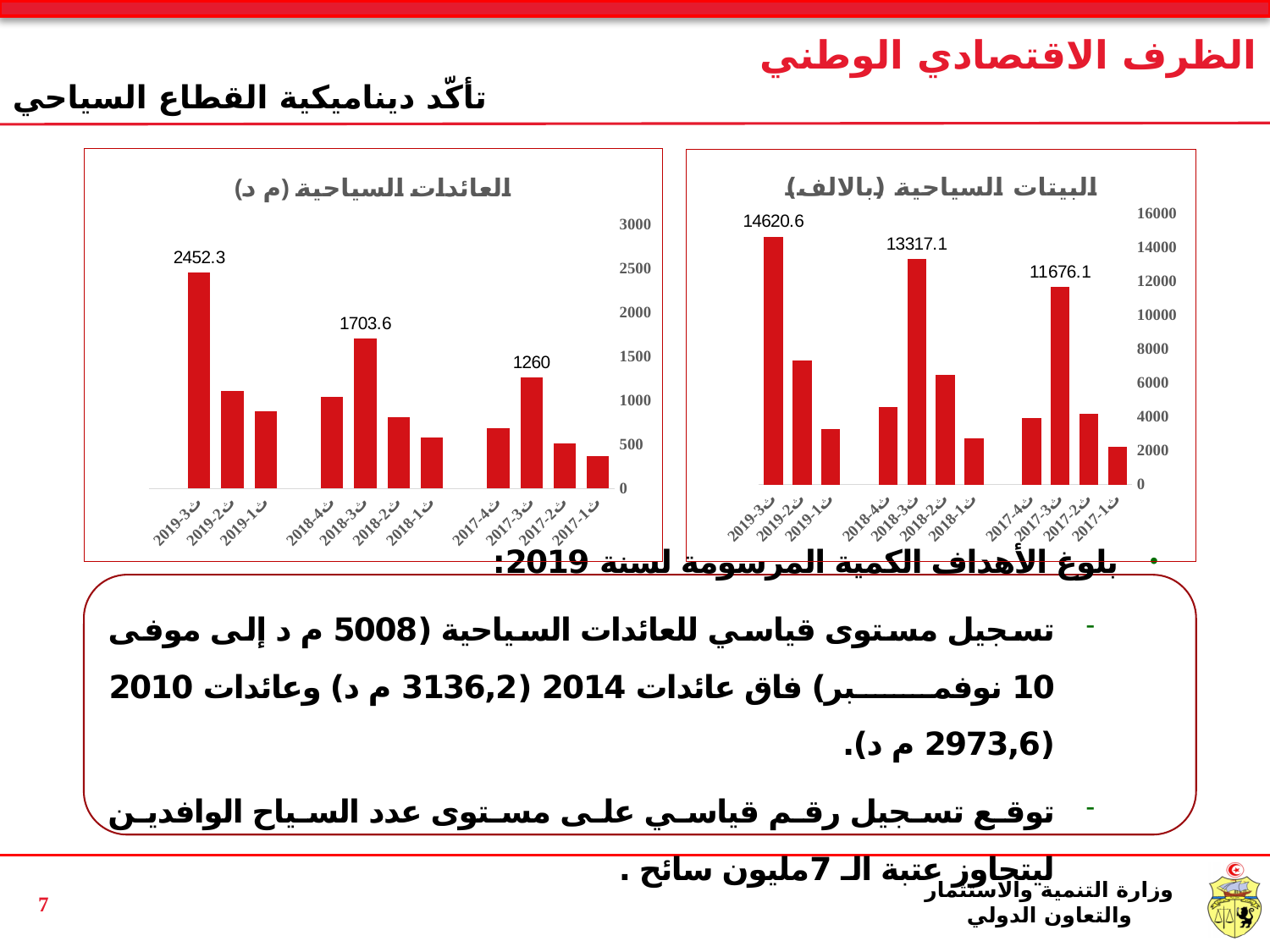
On the right chart (الليالي السياحية بالالف), is the value for ث2-2019 greater or less than 6000? greater On the left chart (العائدات السياحية), what is the value for ث3-2019? 2452.3 On the left chart (العائدات السياحية), what is the difference between the values for ث3-2019 and ث3-2018? 748.7 On the left chart (العائدات السياحية), what is the value for ث3-2018? 1703.6 On the right chart (الليالي السياحية بالالف), what is the difference between the values for ث3-2019 and ث3-2018? 1303.5 On the left chart (العائدات السياحية), is the value for ث1-2017 greater or less than 500? less On the left chart (العائدات السياحية), which category has the highest value? ث3-2019 On the right chart (الليالي السياحية بالالف), which is larger, the value for ث3-2018 or ث3-2017? ث3-2018 On the right chart (الليالي السياحية بالالف), what is the value for ث3-2019? 14620.6 On the right chart (الليالي السياحية بالالف), what is the value for ث3-2017? 11676.1 How many categories are shown on the left chart (العائدات السياحية)? 11 On the right chart (الليالي السياحية بالالف), which category has the lowest value? ث1-2017